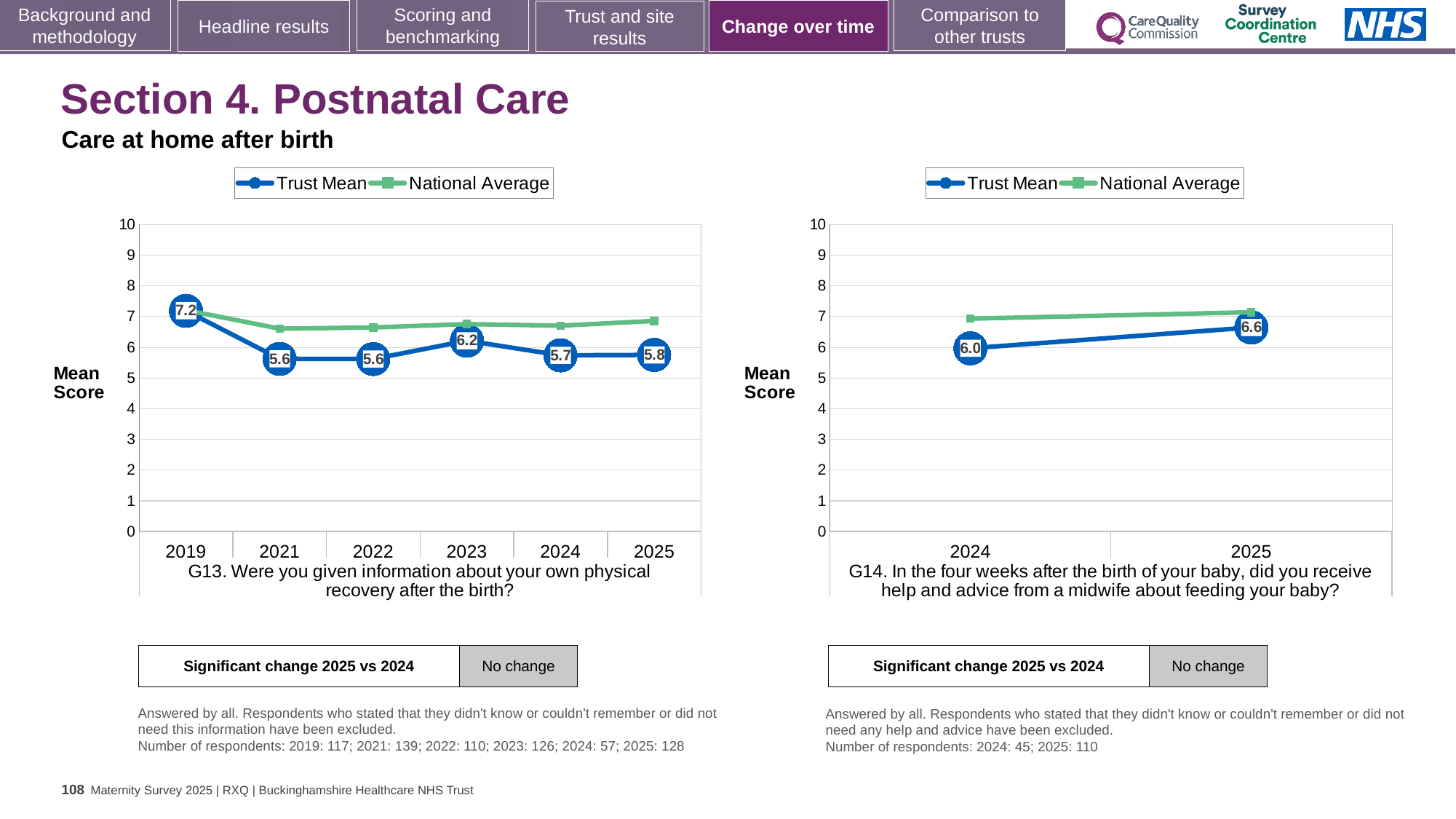
In the G14 chart on the right, how many series does the legend list? 2 In the G14 chart on the right, what is the Trust Mean for 2024? 6.0 In the G13 chart on the left, which year has the highest Trust Mean? 2019 In the G13 chart on the left, what is the Trust Mean for 2019? 7.2 In the G13 chart on the left, what is the Trust Mean for 2025? 5.8 In the G13 chart on the left, how many years are plotted on the x axis? 6 In the G13 chart on the left, what is the Trust Mean for 2023? 6.2 In the G14 chart on the right, what is the Trust Mean for 2025? 6.6 In the G14 chart on the right, does the Trust Mean rise or fall from 2024 to 2025? rise In the G13 chart on the left, what is the difference between the Trust Mean in 2019 and in 2021? 1.6 In the G13 chart on the left, is the National Average for 2025 greater or less than 6? greater What kind of chart is the G13 chart on the left? line chart